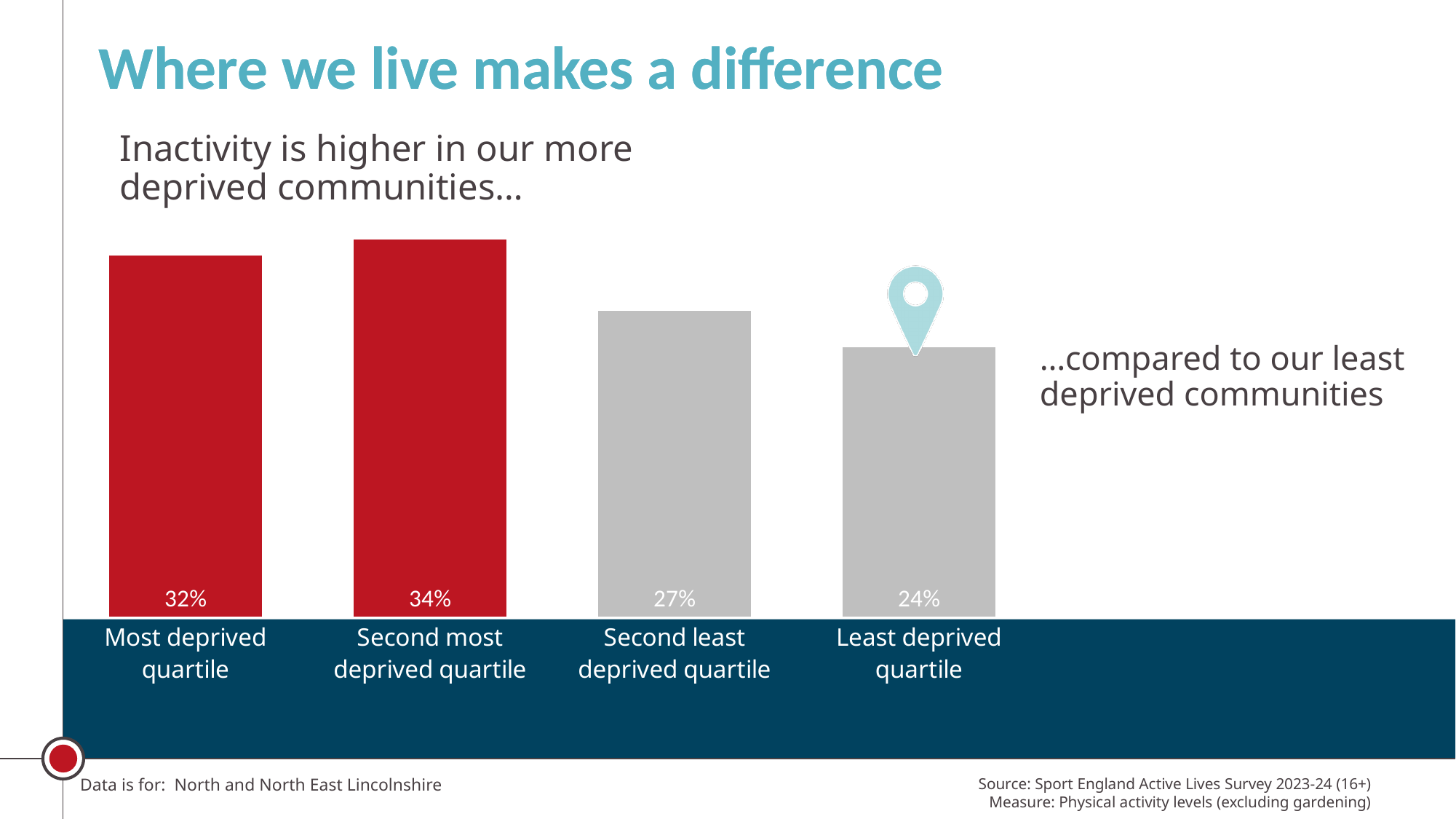
What is the inactivity value for the Least deprived quartile? 24% Which quartile has the highest inactivity value? Second most deprived quartile What is the difference in percentage points between the Second most deprived quartile and the Least deprived quartile? 10 Which has a higher inactivity value, the Most deprived quartile or the Second least deprived quartile? Most deprived quartile What kind of chart is shown on the slide? Bar chart What is the inactivity value for the Second most deprived quartile? 34% What colour are the bars for the two most deprived quartiles? Red What is the inactivity value for the Second least deprived quartile? 27% What is the inactivity value for the Most deprived quartile? 32% Which quartile has the lowest inactivity value? Least deprived quartile How many quartile categories are shown in the chart? 4 What is the difference in percentage points between the Most deprived quartile and the Second least deprived quartile? 5